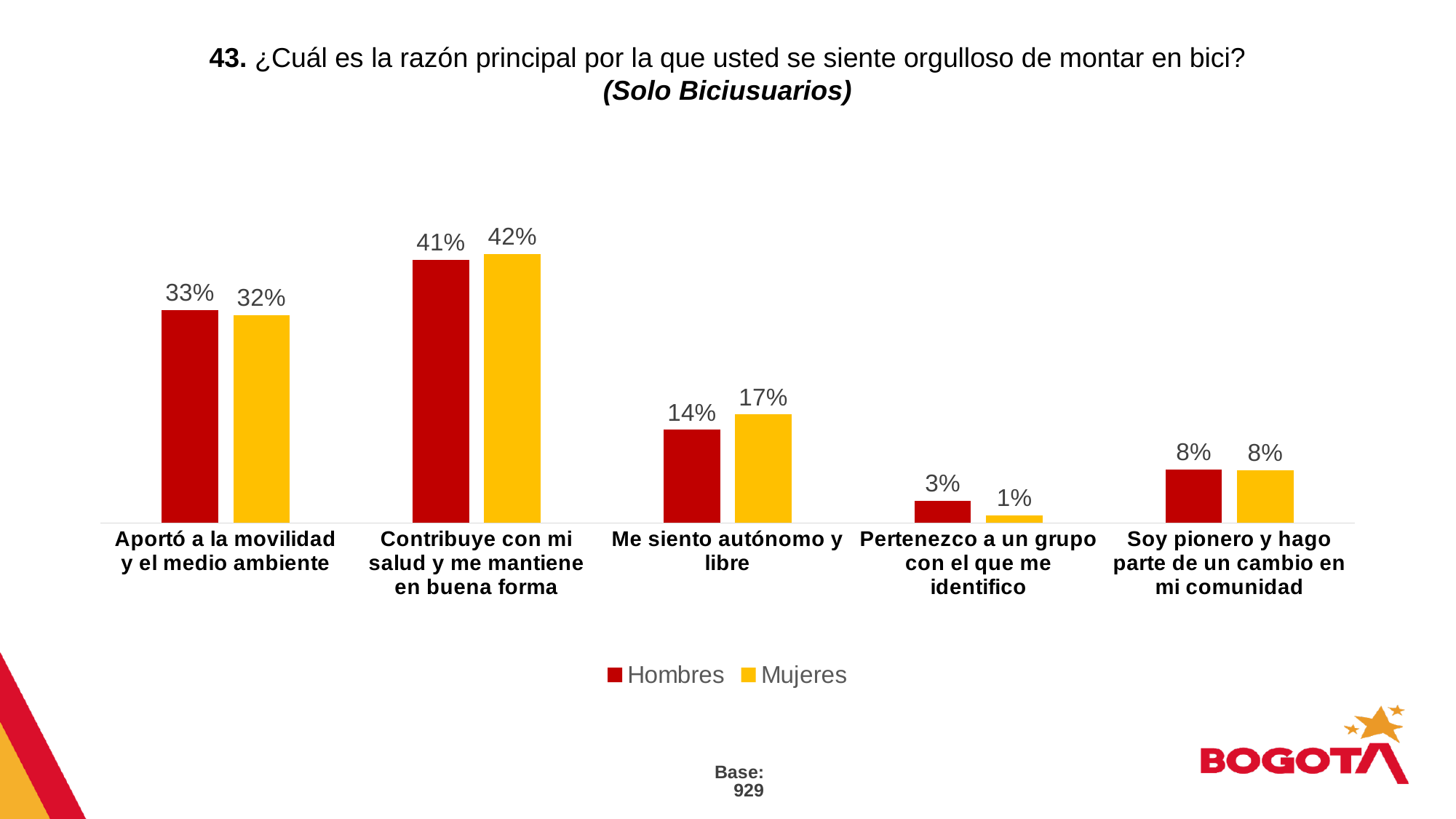
Which category has the lowest Hombres value? Pertenezco a un grupo con el que me identifico How many series does the legend list? 2 What is the Mujeres value for "Pertenezco a un grupo con el que me identifico"? 1% How many categories are shown on the x axis? 5 What is the difference between the Hombres values for "Contribuye con mi salud y me mantiene en buena forma" and "Aportó a la movilidad y el medio ambiente"? 8% What kind of chart is shown on the slide? Bar chart For "Pertenezco a un grupo con el que me identifico", which series has the larger value, Hombres or Mujeres? Hombres What is the Hombres value for "Contribuye con mi salud y me mantiene en buena forma"? 41% Which category has the highest Mujeres value? Contribuye con mi salud y me mantiene en buena forma What is the Mujeres value for "Me siento autónomo y libre"? 17% What is the difference between the Hombres and Mujeres values for "Me siento autónomo y libre"? 3% What colour represents the Mujeres series? Yellow